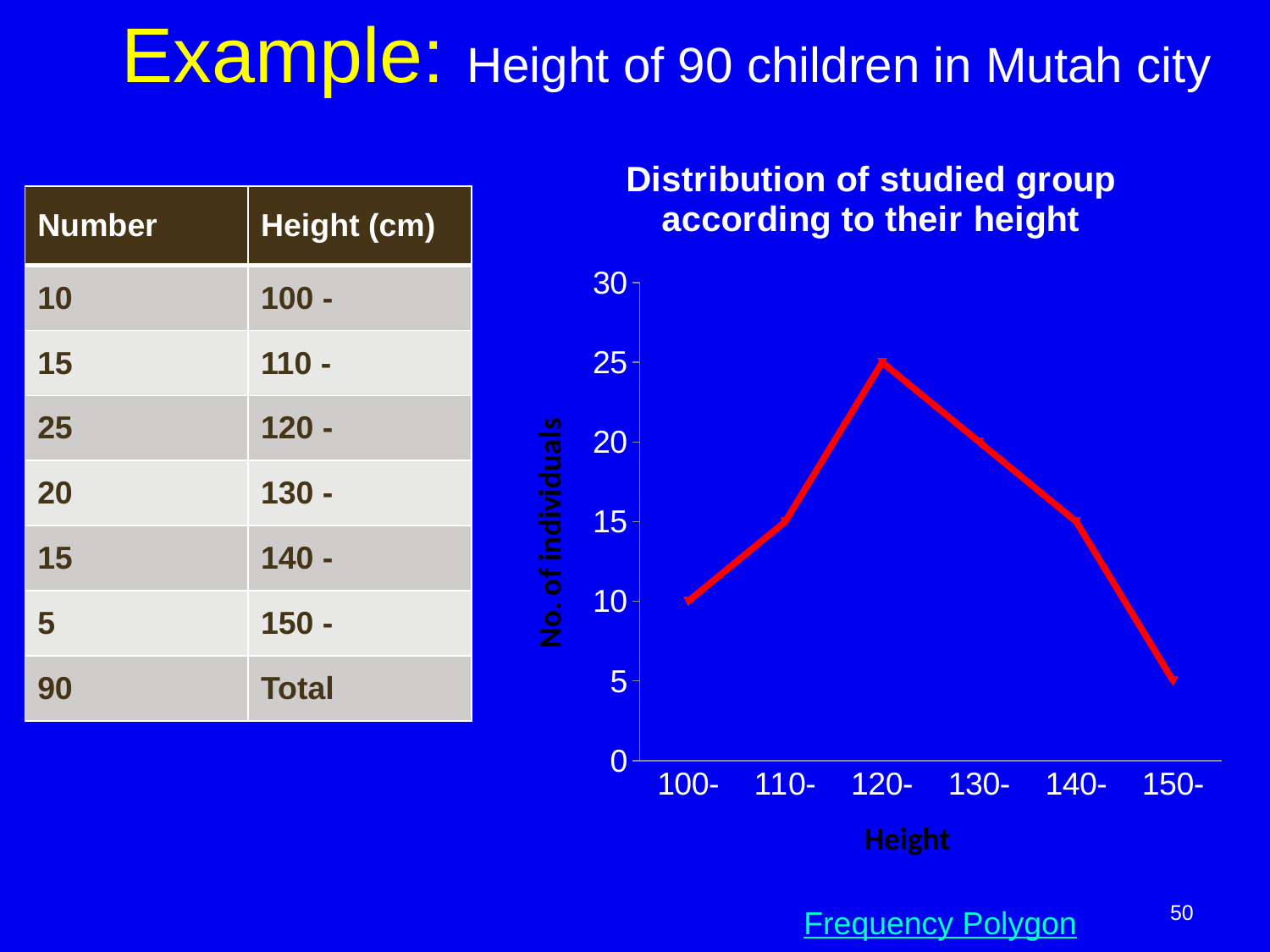
What is the number of individuals for the 120- height category? 25 Which height category has the highest number of individuals? 120- What is the difference in number of individuals between the 120- and 130- categories? 5 What is the title of the chart? Distribution of studied group according to their height How many height categories are plotted on the x axis of the chart? 6 What is the number of individuals for the 100- height category? 10 Which height category has the lowest number of individuals? 150- Which has more individuals, the 110- category or the 130- category? 130- What is the number of individuals for the 150- height category? 5 Do the values rise or fall from the 120- category to the 150- category? fall Is the value for the 140- category greater or less than 20? less What kind of chart is shown on the slide? line chart